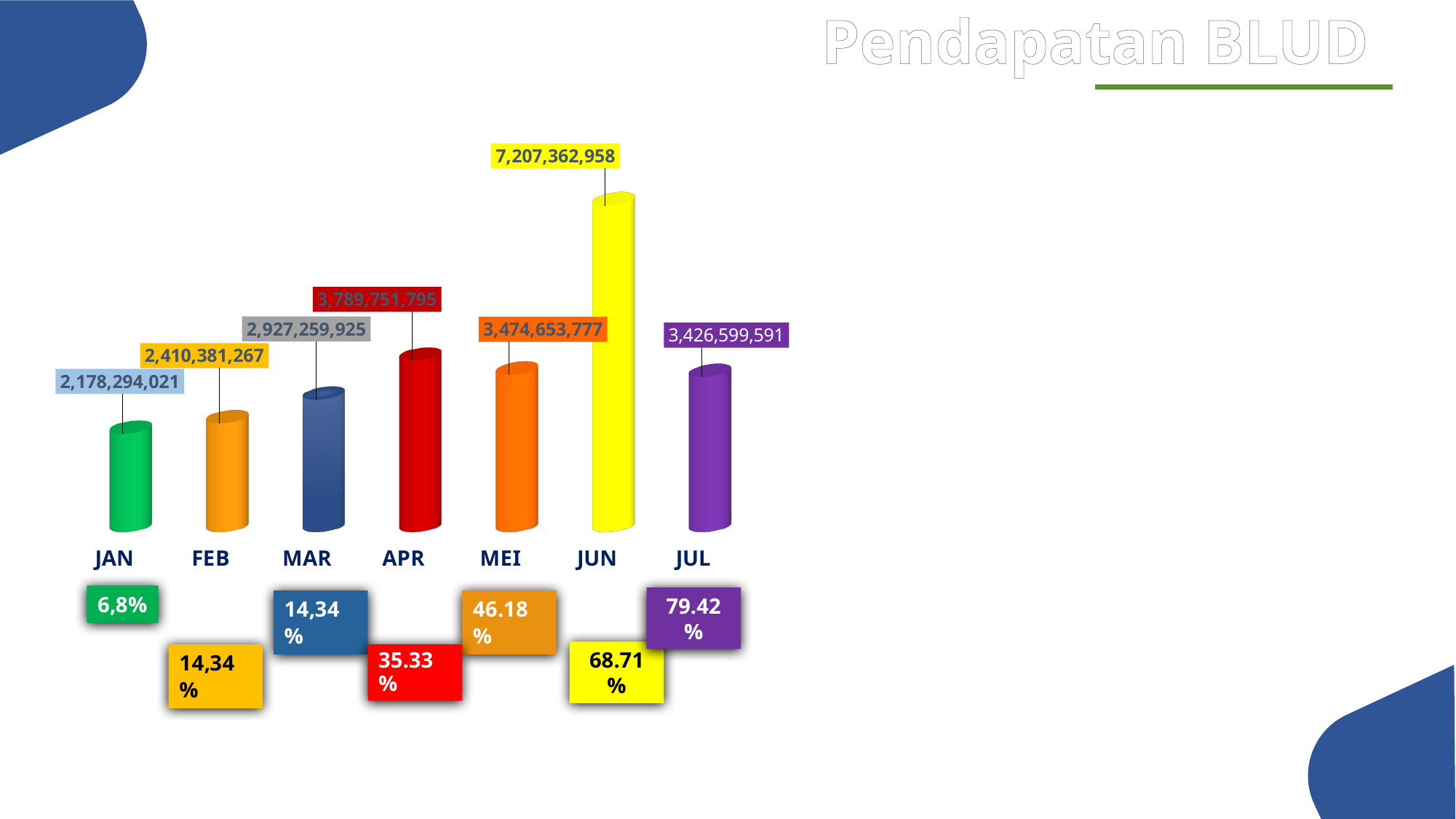
What is the difference between the values for JUN and JAN? 5,029,068,937 What kind of chart is shown on the slide? Bar chart Which month has the highest value? JUN What is the value for JAN? 2,178,294,021 What is the value for JUL? 3,426,599,591 How many months are shown on the chart? 7 What is the value for APR? 3,789,751,795 Which month has the lowest value? JAN What is the value for JUN? 7,207,362,958 Which is larger, the value for APR or the value for MEI? APR What is the difference between the values for FEB and JAN? 232,087,246 What is the title of the slide containing the chart? Pendapatan BLUD